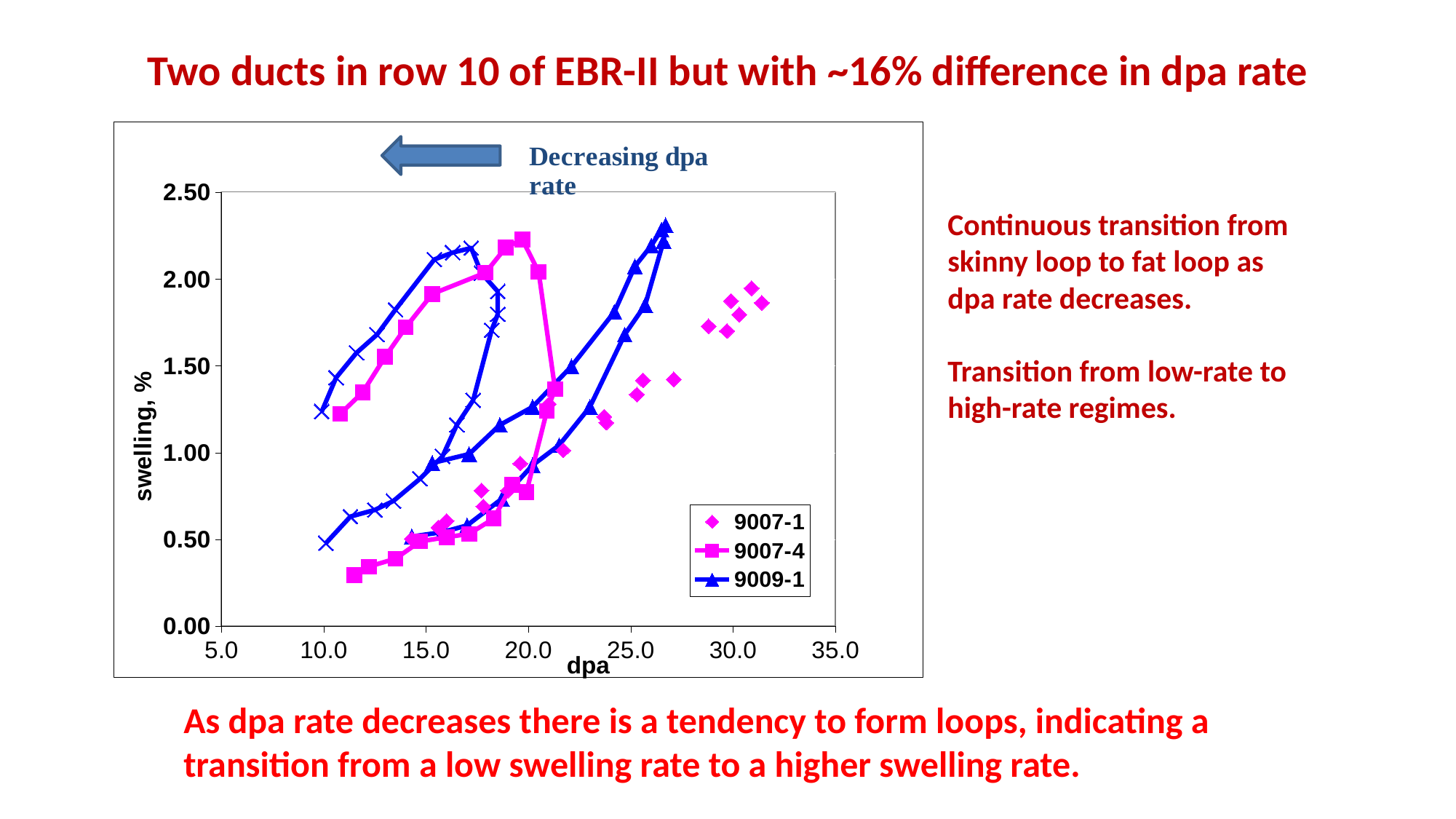
Is the maximum swelling reached by series 9007-4 greater or less than 2.00? greater Is the maximum swelling reached by series 9009-1 greater or less than 2.00? greater What is the label of the y axis? swelling, % What are the names of the series listed in the legend? 9007-1, 9007-4, 9009-1 Is the lowest swelling value of series 9007-4 greater or less than 0.50? less Which series reaches a higher maximum swelling, 9007-1 or 9009-1? 9009-1 Which series extends to the highest dpa values on the x axis? 9007-1 What kind of chart is shown on the slide? scatter chart How many series does the legend list? 3 Does swelling generally rise or fall as dpa increases along the lower branch of series 9007-4? rise